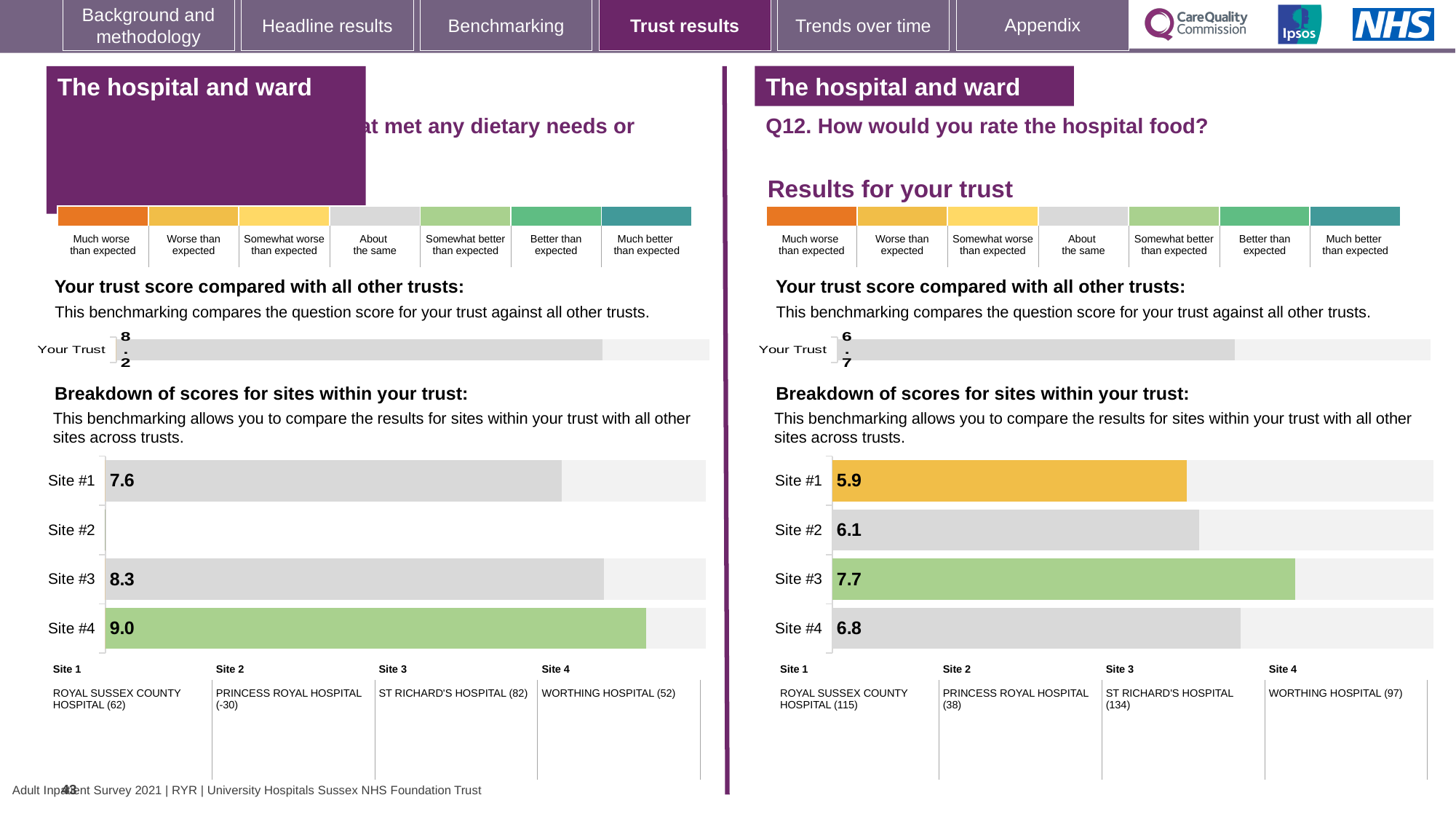
On the left-hand site breakdown chart, what is the score for Site #4? 9.0 On the right-hand chart (Q12, hospital food), what is the difference between the scores for Site #3 and Site #1? 1.8 On the left-hand site breakdown chart, what is the score for Site #1? 7.6 On the right-hand chart (Q12, hospital food), what is the score for Site #1? 5.9 On the right-hand chart (Q12, hospital food), which site has the lowest score? Site #1 On the right-hand 'Your trust score compared with all other trusts' chart (Q12), what is the score for Your Trust? 6.7 On the right-hand chart (Q12, hospital food), which is larger, the score for Site #2 or Site #4? Site #4 On the left-hand site breakdown chart, which site has the highest score? Site #4 What kind of chart is the right-hand site breakdown chart (Q12, hospital food)? Bar chart On the right-hand chart (Q12, hospital food), which site has the highest score? Site #3 On the right-hand chart (Q12, hospital food), what is the score for Site #3? 7.7 On the left-hand site breakdown chart, what is the difference between the scores for Site #4 and Site #3? 0.7